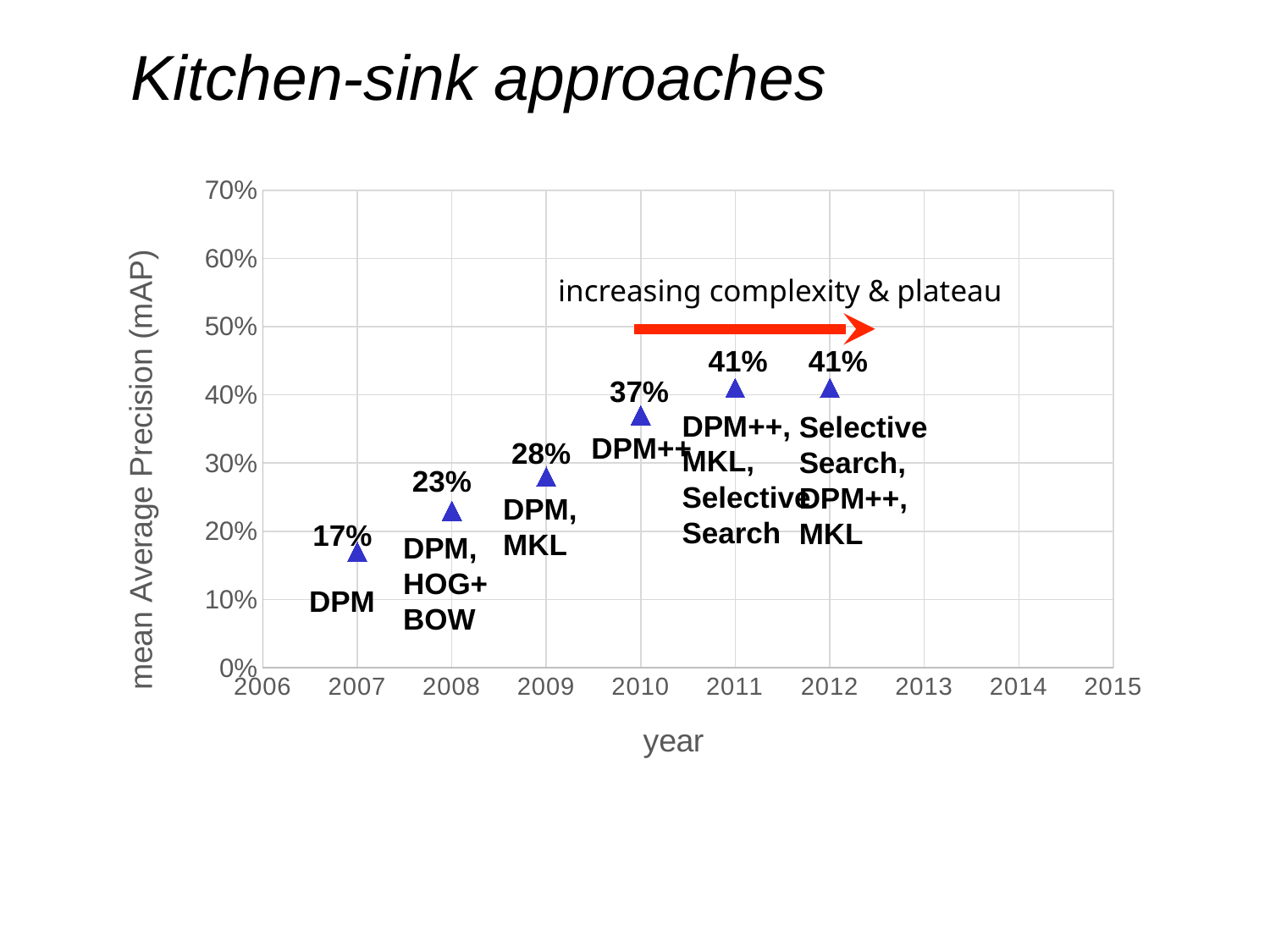
Do the mAP values rise or fall from 2007 to 2011? rise What is the highest mAP value shown on the chart? 41% What is the difference between the mAP values for 2010 and 2008? 14% Which year has the lowest plotted mAP value? 2007 What type of chart is shown on the slide? scatter chart Which year has a larger mAP value, 2008 or 2009? 2009 How many data points are plotted on the chart? 6 What method label is attached to the 2007 data point? DPM What is the mAP value plotted for 2009? 28% What is the mean Average Precision (mAP) value plotted for 2007? 17% What is the difference between the mAP values for 2011 and 2007? 24% What is the mAP value plotted for 2010? 37%